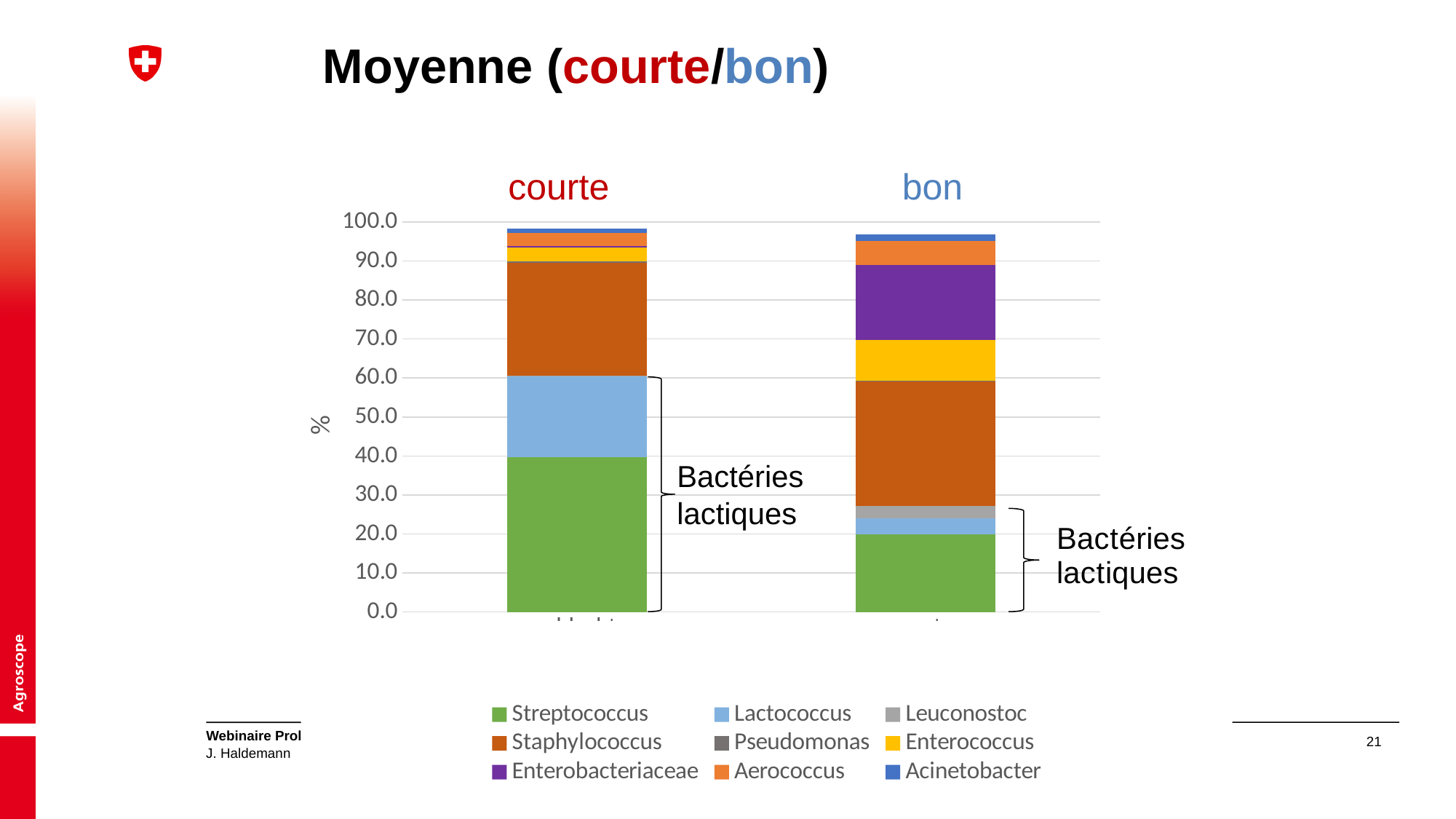
How many series does the legend list? 9 Which bar has the larger Streptococcus value, courte or bon? courte How many bars are plotted in the chart? 2 Which bar has the larger Lactococcus value, courte or bon? courte Which bar has the larger Enterococcus value, courte or bon? bon What is the label on the y axis of the chart? % What kind of chart is shown on the slide? stacked bar chart Is the Streptococcus value for the courte bar greater or less than 30? greater Is the Enterobacteriaceae value for the bon bar greater or less than 10? greater Is the Streptococcus value for the bon bar greater or less than 30? less